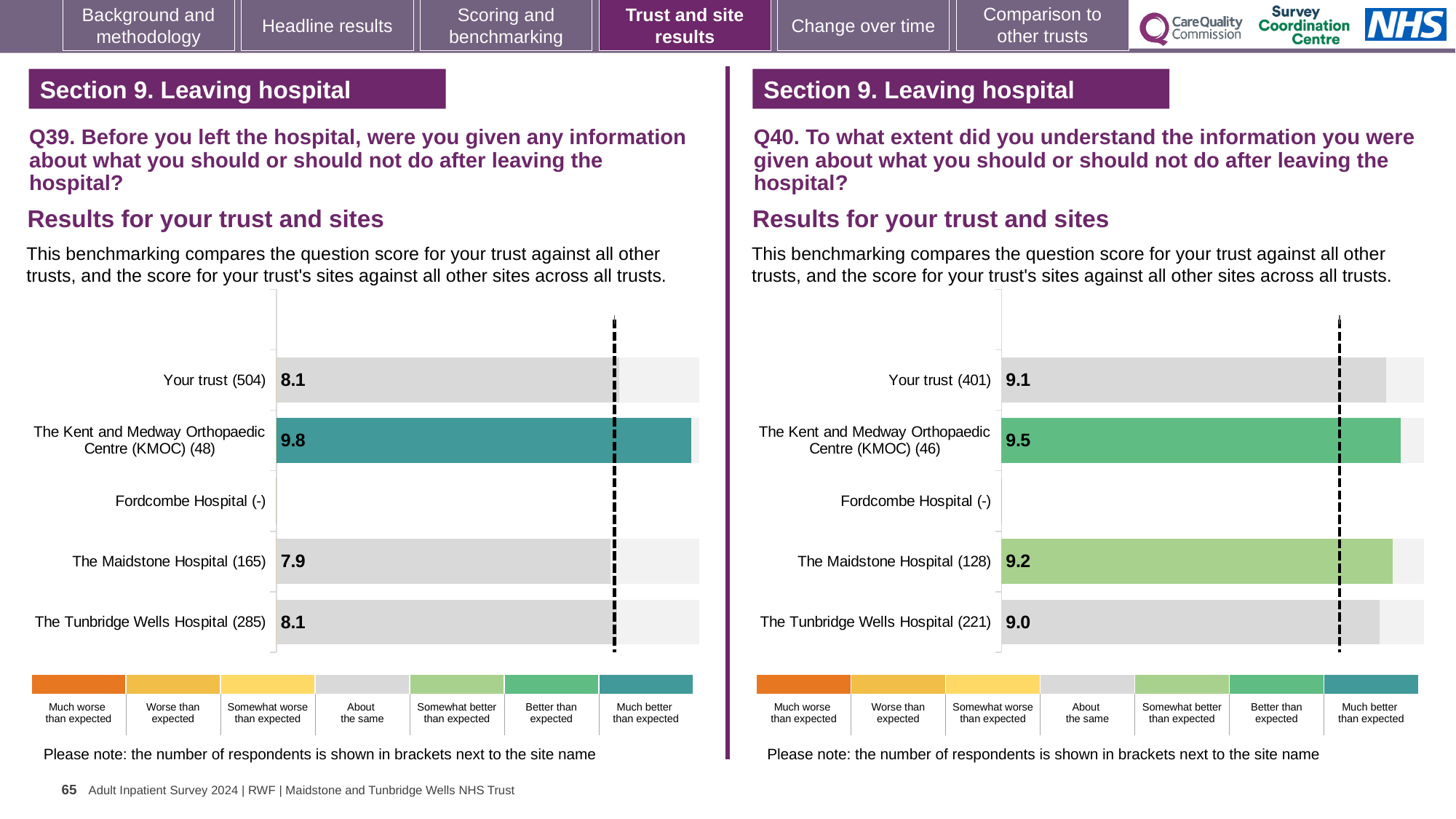
What kind of chart is used in the Q39 chart (left)? Bar chart In the Q40 chart (right), which site has no score shown? Fordcombe Hospital In the Q40 chart (right), which site has the highest score? The Kent and Medway Orthopaedic Centre (KMOC) In the Q40 chart (right), which is larger: the score for Your trust or the score for The Maidstone Hospital? The Maidstone Hospital In the Q39 chart (left), what is the score for The Kent and Medway Orthopaedic Centre (KMOC)? 9.8 In the Q40 chart (right), what is the difference between the scores for The Kent and Medway Orthopaedic Centre (KMOC) and The Tunbridge Wells Hospital? 0.5 In the Q39 chart (left), which site has the lowest score? The Maidstone Hospital In the Q40 chart (right), what is the score for The Maidstone Hospital? 9.2 In the Q40 chart (right), what is the score for The Tunbridge Wells Hospital? 9.0 In the Q39 chart (left), what is the difference between the scores for The Kent and Medway Orthopaedic Centre (KMOC) and The Maidstone Hospital? 1.9 In the Q39 chart (left), what is the score for Your trust? 8.1 In the Q39 chart (left), how many respondents are shown for The Tunbridge Wells Hospital? 285